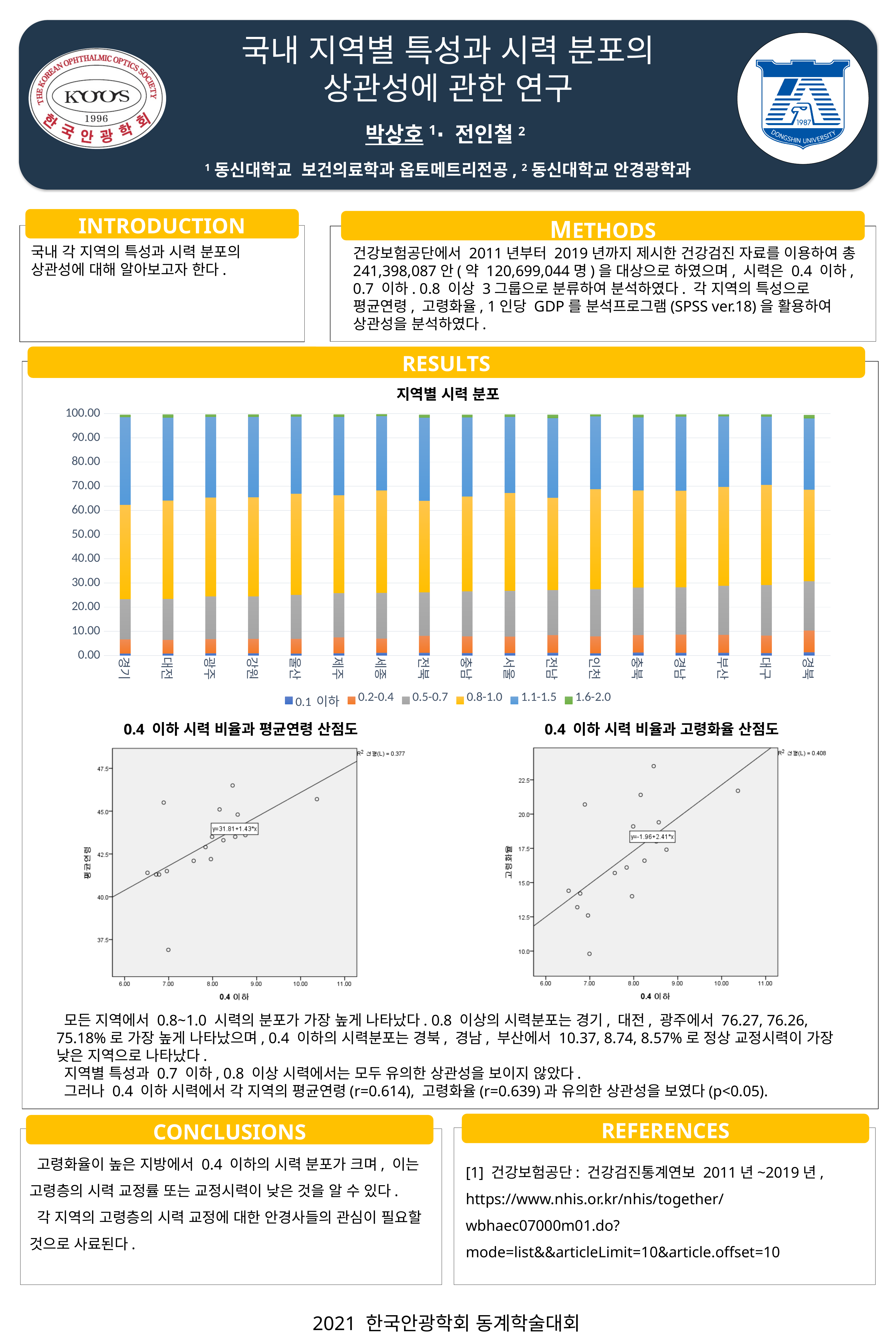
How many series does the legend of the '지역별 시력 분포' chart list? 6 In the '지역별 시력 분포' chart, which region is the first category on the x axis? 경기 In the '지역별 시력 분포' chart, is the cumulative top of the 0.8-1.0 segment for 경기 greater or less than 70? less What R² value is printed on the '0.4 이하 시력 비율과 고령화율 산점도' chart? 0.408 In the '0.4 이하 시력 비율과 평균연령 산점도' chart, does the fitted line rise or fall as the x value increases? rise In the '지역별 시력 분포' chart, is the cumulative top of the 0.5-0.7 segment for 경기 greater or less than 30? less What kind of chart is the '지역별 시력 분포' chart? stacked bar chart In the '지역별 시력 분포' chart, which series is shown in yellow? 0.8-1.0 What regression equation is printed on the '0.4 이하 시력 비율과 고령화율 산점도' chart? y=-1.96+2.41*x What R² value is printed on the '0.4 이하 시력 비율과 평균연령 산점도' chart? 0.377 What kind of chart is the '0.4 이하 시력 비율과 평균연령 산점도'? scatter plot How many regions are shown on the x axis of the '지역별 시력 분포' chart? 17